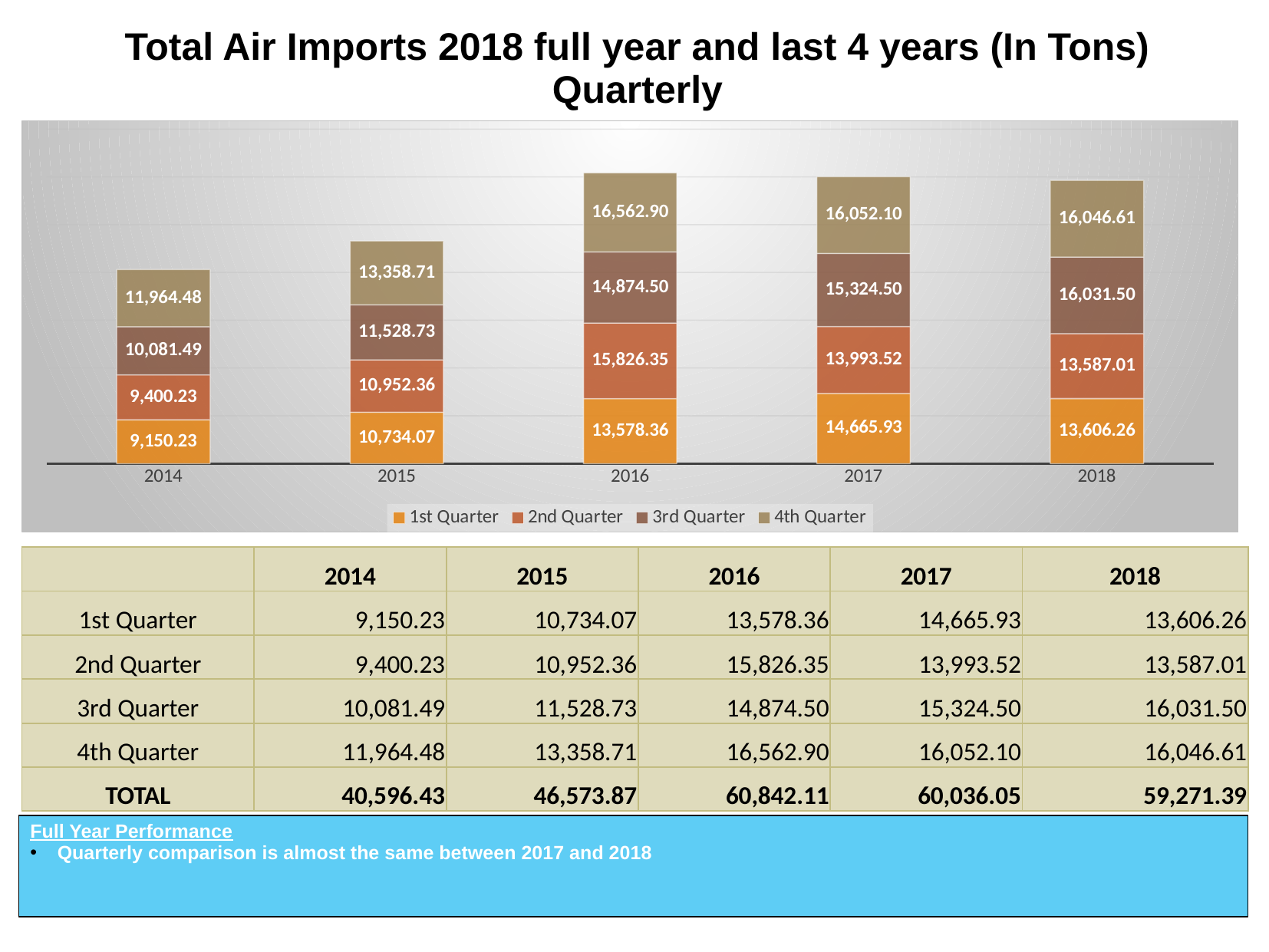
What kind of chart is shown on the slide? Stacked bar chart How many years are shown on the x axis of the chart? 5 What is the difference between the 3rd Quarter values for 2018 and 2017? 707.00 How many series does the legend list? 4 Which year has the highest 4th Quarter value? 2016 Which series is shown in orange at the bottom of each bar? 1st Quarter What is the 4th Quarter value for 2014? 11,964.48 Which year has the lowest 1st Quarter value? 2014 What is the 2nd Quarter value for 2018? 13,587.01 What is the 1st Quarter value for 2016? 13,578.36 Which is larger, the 2nd Quarter value for 2016 or the 2nd Quarter value for 2017? 2016 What is the total of the stacked bar for 2015? 46,573.87